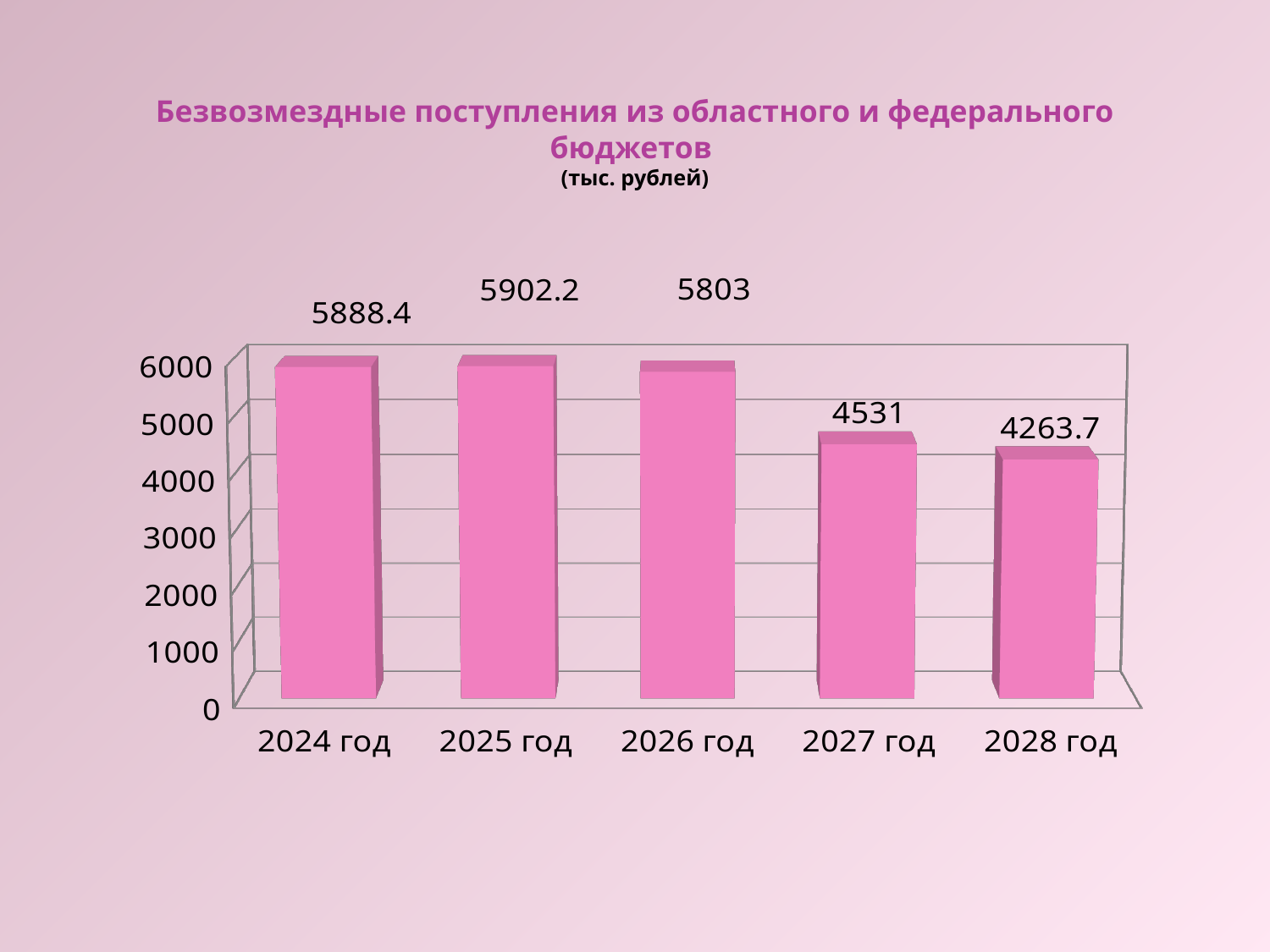
What is the value for 2027 год? 4531 Is the value for 2028 год greater or less than 5000? less What is the difference between the values for 2027 год and 2028 год? 267.3 Which year has the highest value? 2025 год Which year has the lowest value? 2028 год What is the value for 2025 год? 5902.2 How many years are shown on the chart? 5 What kind of chart is shown on the slide? bar chart Which is larger, the value for 2024 год or the value for 2027 год? 2024 год What is the value for 2028 год? 4263.7 What is the difference between the values for 2026 год and 2027 год? 1272 What unit is given under the chart title? тыс. рублей